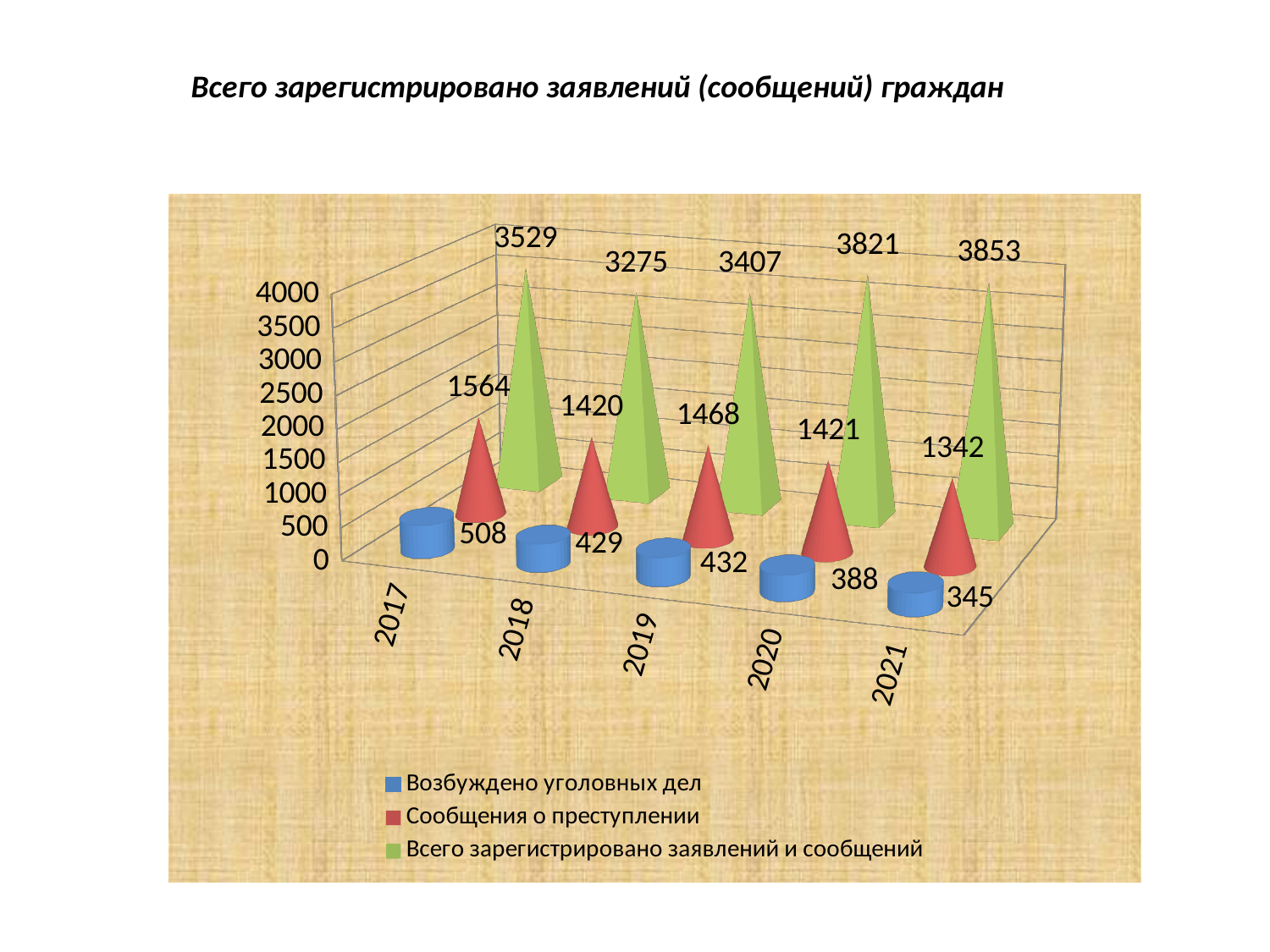
What is the value for "Сообщения о преступлении" in 2019? 1468 In which year is "Всего зарегистрировано заявлений и сообщений" the lowest? 2018 Does the value for "Возбуждено уголовных дел" rise or fall from 2019 to 2021? Fall Which colour represents "Сообщения о преступлении" in the legend? Red Which is larger: "Всего зарегистрировано заявлений и сообщений" in 2019 or in 2020? 2020 In which year is "Возбуждено уголовных дел" the highest? 2017 How many years are shown on the x axis? 5 What is the difference between the "Сообщения о преступлении" values for 2017 and 2021? 222 What kind of chart is shown on the slide? Bar chart How many series does the legend list? 3 What is the value for "Всего зарегистрировано заявлений и сообщений" in 2021? 3853 What is the value for "Возбуждено уголовных дел" in 2017? 508